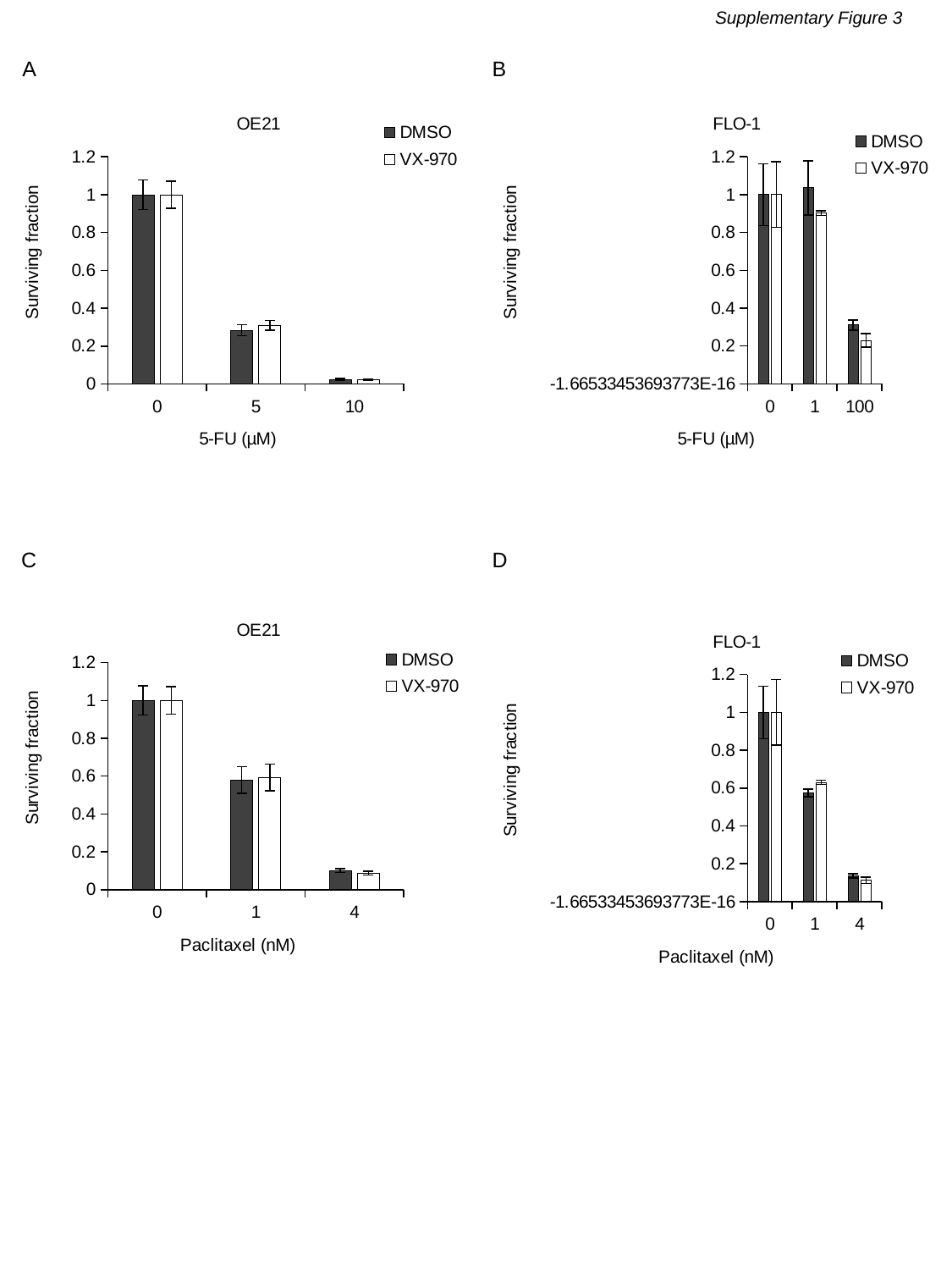
In chart C (OE21, Paclitaxel), which paclitaxel concentration has the highest DMSO surviving fraction? 0 In chart B (FLO-1, 5-FU), is the VX-970 value at 100 µM greater or less than 0.4? less In chart A (OE21, 5-FU), do the surviving fraction values rise or fall as the 5-FU concentration increases? fall In chart B (FLO-1, 5-FU), what is the label of the x axis? 5-FU (µM) In chart A (OE21, 5-FU), is the DMSO value at 5 µM greater or less than 0.4? less In chart C (OE21, Paclitaxel), is the DMSO value at 1 nM greater or less than 0.4? greater In chart B (FLO-1, 5-FU), which 5-FU concentration has the lowest DMSO surviving fraction? 100 In chart D (FLO-1, Paclitaxel), which is larger: the DMSO value at 1 nM or the DMSO value at 4 nM? DMSO at 1 nM In chart A (OE21, 5-FU), what kind of chart is shown? bar chart In chart A (OE21, 5-FU), how many 5-FU concentrations are shown on the x axis? 3 In chart A (OE21, 5-FU), how many series does the legend list? 2